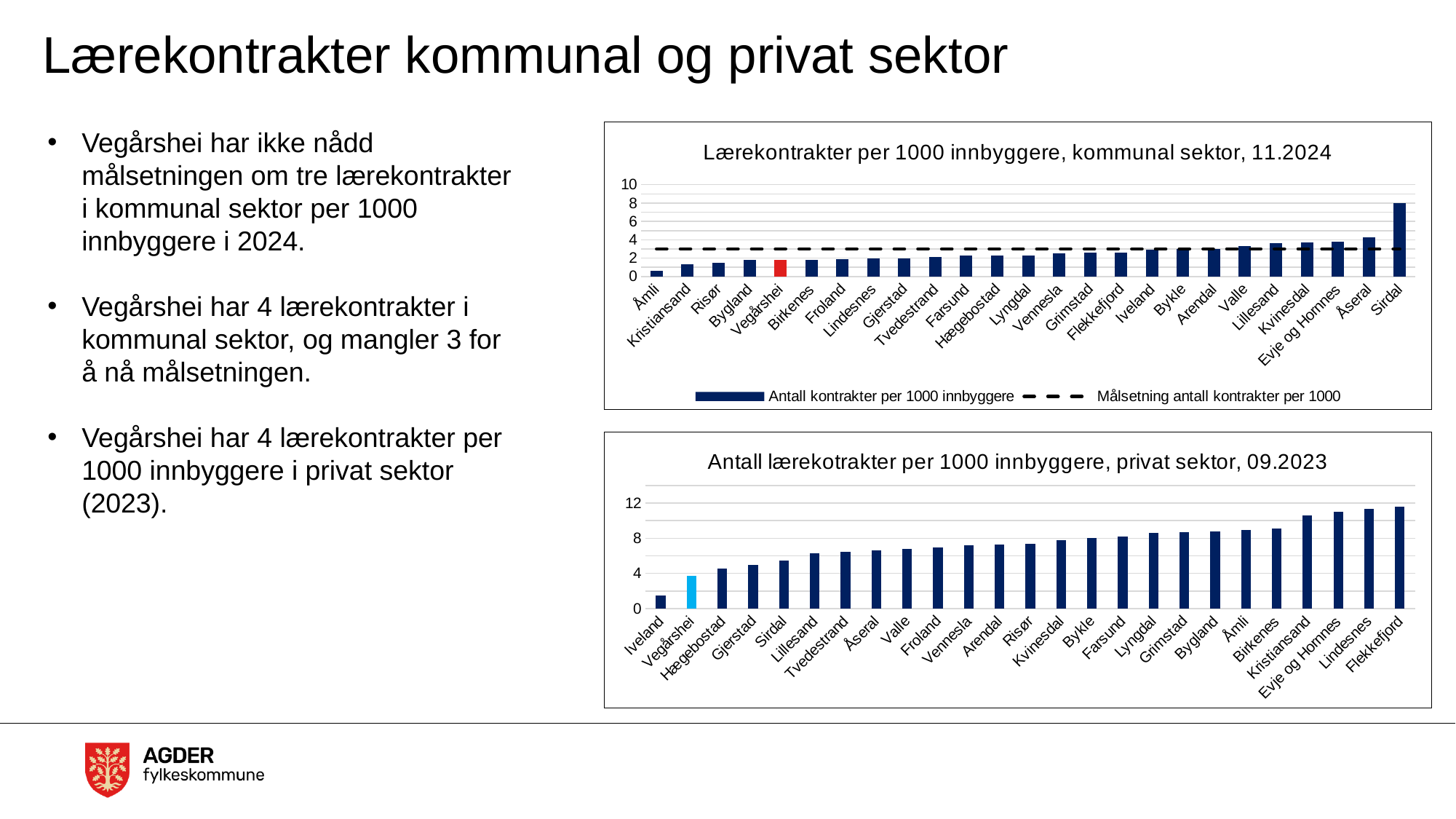
In the bottom chart (privat sektor, 09.2023), which municipality has the highest value? Flekkefjord In the top chart (kommunal sektor, 11.2024), which bar is coloured red? Vegårshei What kind of chart is the top chart, 'Lærekontrakter per 1000 innbyggere, kommunal sektor, 11.2024'? Combination bar and line chart (bars with a dashed target line) In the bottom chart (privat sektor, 09.2023), do the values rise or fall from left to right along the x axis? Rise In the bottom chart (privat sektor, 09.2023), which municipality has the lowest value? Iveland In the top chart (kommunal sektor, 11.2024), which municipality has the highest value? Sirdal How many municipalities are shown in the top chart (kommunal sektor, 11.2024)? 25 How many entries does the legend of the top chart (kommunal sektor, 11.2024) list? 2 In the bottom chart (privat sektor, 09.2023), is the value for Kristiansand greater or less than 8? greater In the top chart (kommunal sektor, 11.2024), which municipality has the lowest value? Åmli In the top chart (kommunal sektor, 11.2024), is the value for Åmli greater or less than 2? less In the top chart (kommunal sektor, 11.2024), is the value for Sirdal greater or less than 6? greater